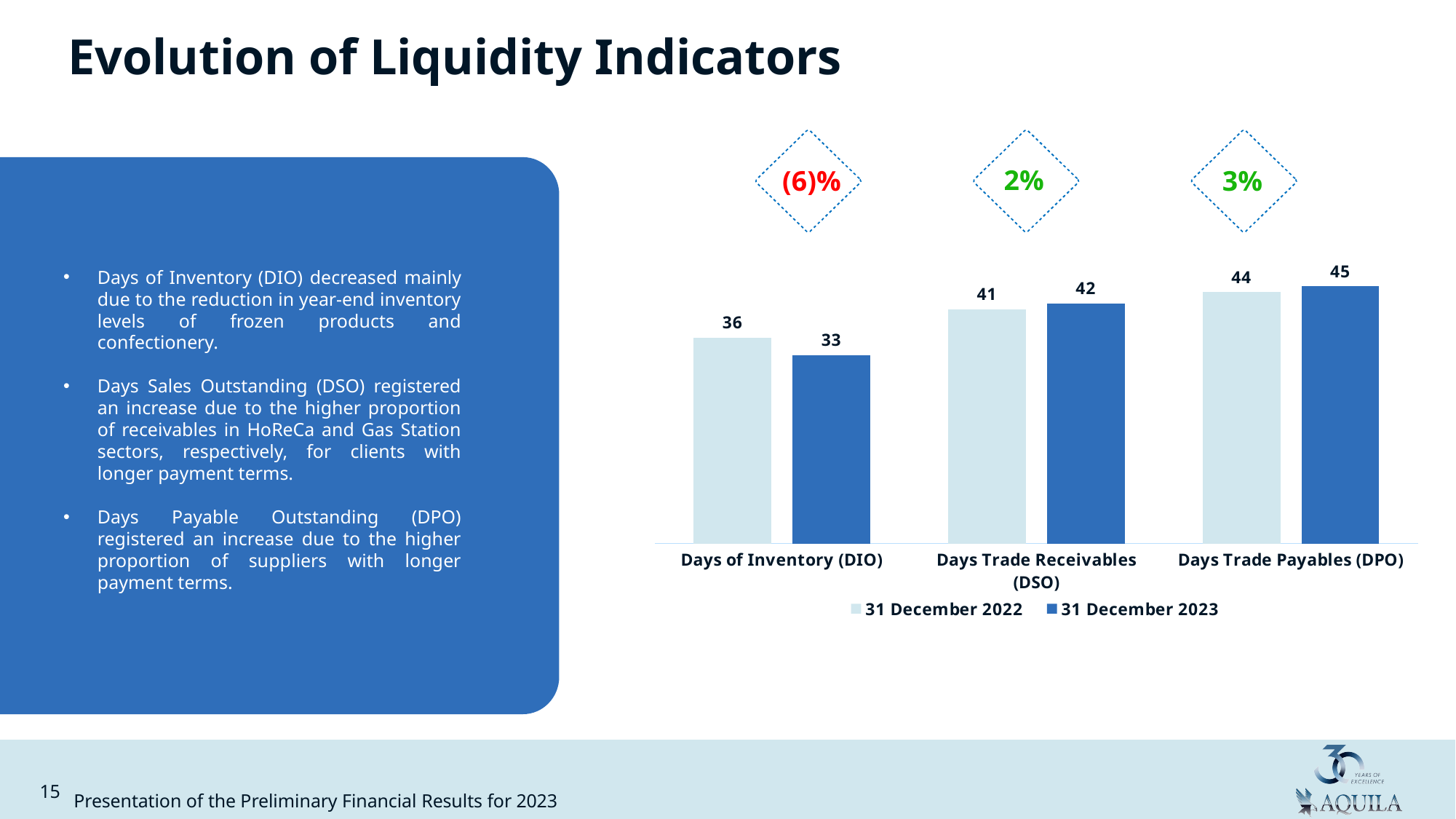
What is the value for Days Trade Receivables (DSO) at 31 December 2023? 42 How many series does the chart legend list? 2 What is the difference between the 31 December 2023 values for Days Trade Payables (DPO) and Days Trade Receivables (DSO)? 3 Which category has the highest value for 31 December 2023? Days Trade Payables (DPO) How many categories are shown on the x axis of the chart? 3 Which is larger for Days Trade Receivables (DSO): the 31 December 2022 value or the 31 December 2023 value? 31 December 2023 What is the difference between the 31 December 2022 and 31 December 2023 values for Days of Inventory (DIO)? 3 What is the value for Days Trade Payables (DPO) at 31 December 2022? 44 What is the value for Days of Inventory (DIO) at 31 December 2022? 36 Which category has the lowest value for 31 December 2022? Days of Inventory (DIO) What kind of chart is shown on the slide? Bar chart What is the value for Days of Inventory (DIO) at 31 December 2023? 33